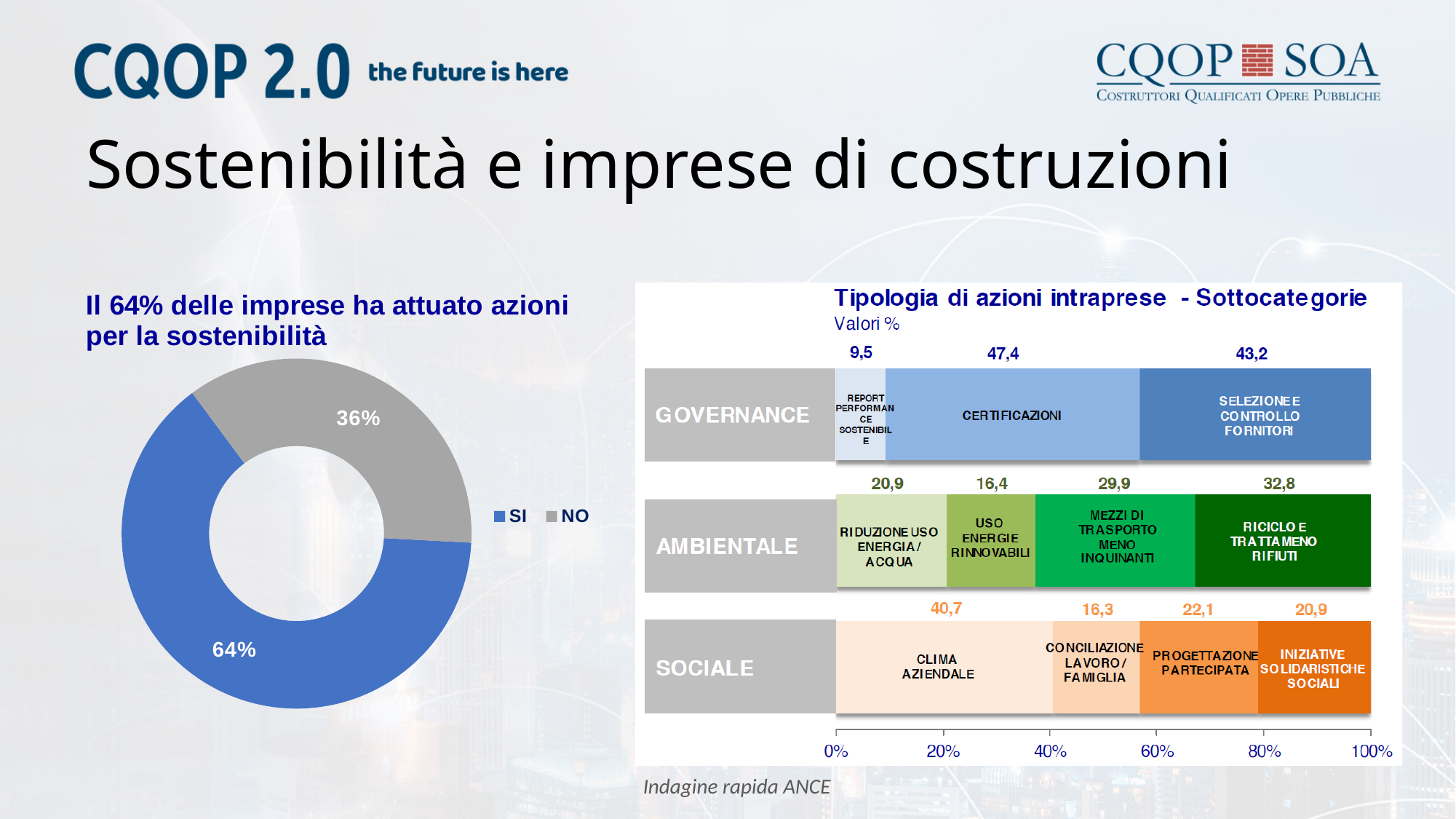
In the chart 'Tipologia di azioni intraprese - Sottocategorie', how many segments make up the AMBIENTALE bar? 4 In the chart 'Tipologia di azioni intraprese - Sottocategorie', what is the value for RICICLO E TRATTAMENTO RIFIUTI in the AMBIENTALE bar? 32,8 In the chart 'Tipologia di azioni intraprese - Sottocategorie', which segment of the SOCIALE bar has the largest value? CLIMA AZIENDALE In the donut chart on the left, what share of companies answered SI? 64% What kind of chart is 'Tipologia di azioni intraprese - Sottocategorie'? Stacked bar chart In the chart 'Tipologia di azioni intraprese - Sottocategorie', what is the value for CERTIFICAZIONI in the GOVERNANCE bar? 47,4 In the chart 'Tipologia di azioni intraprese - Sottocategorie', what is the difference between the values for CERTIFICAZIONI and SELEZIONE E CONTROLLO FORNITORI? 4,2 In the donut chart on the left, how many entries does the legend list? 2 In the chart 'Tipologia di azioni intraprese - Sottocategorie', which segment of the GOVERNANCE bar has the smallest value? REPORT PERFORMANCE SOSTENIBILE In the chart 'Tipologia di azioni intraprese - Sottocategorie', what is the value for CLIMA AZIENDALE in the SOCIALE bar? 40,7 In the donut chart on the left, which answer has the larger share, SI or NO? SI In the donut chart on the left, what share of companies answered NO? 36%